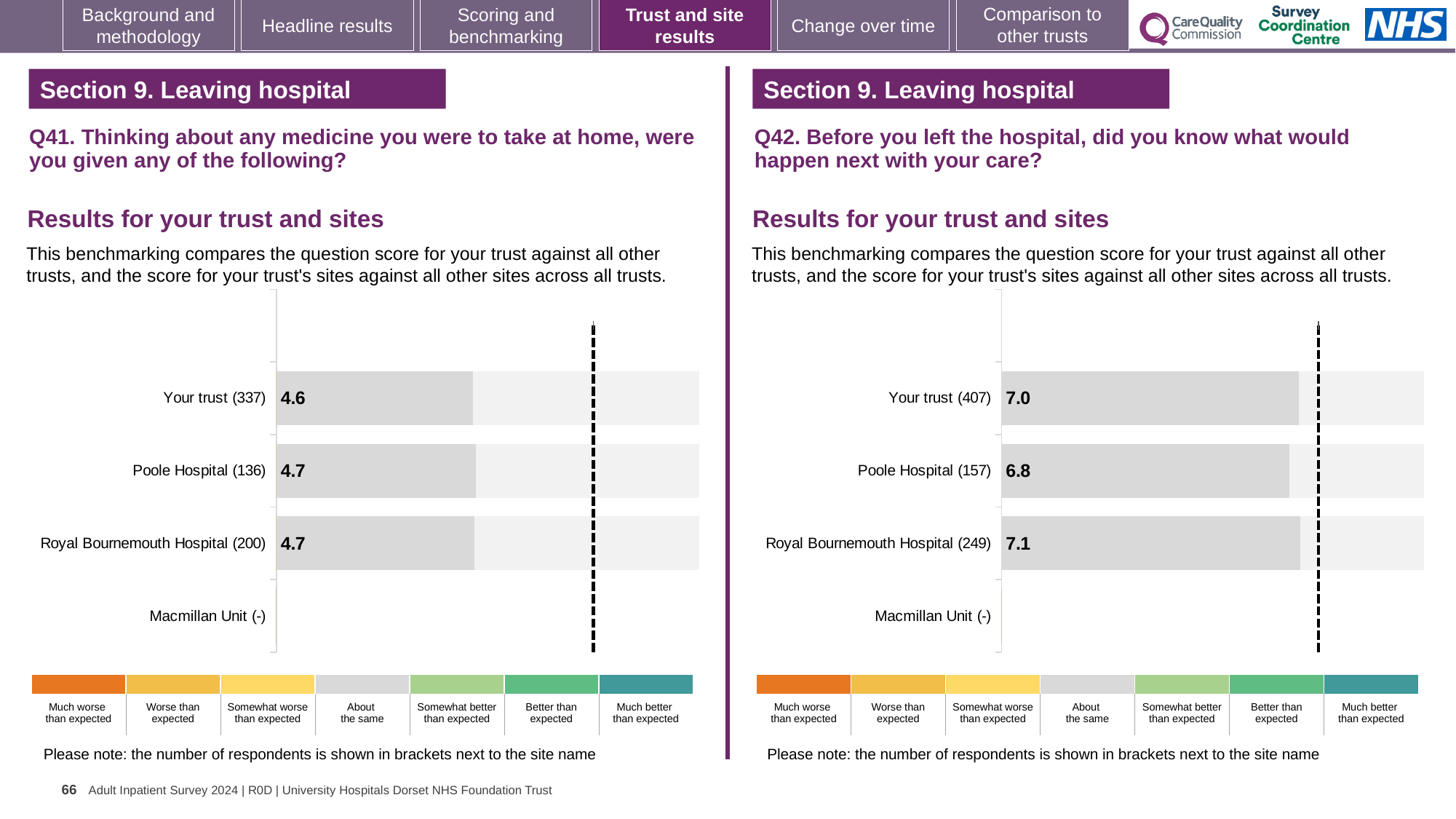
In the Q42 chart on the right, what is the score for Poole Hospital (157)? 6.8 In the Q41 chart on the left, which category has the lowest score among those with a value shown? Your trust (337) In the Q41 chart on the left, what is the score for Your trust (337)? 4.6 In the Q41 chart on the left, which has the larger score: Your trust (337) or Royal Bournemouth Hospital (200)? Royal Bournemouth Hospital (200) In the Q41 chart on the left, which category has no score shown? Macmillan Unit (-) In the Q42 chart on the right, which category has the lowest score among those with a value shown? Poole Hospital (157) In the Q41 chart on the left, what is the score for Poole Hospital (136)? 4.7 In the Q42 chart on the right, which category has the highest score? Royal Bournemouth Hospital (249) In the Q42 chart on the right, what is the score for Royal Bournemouth Hospital (249)? 7.1 What kind of chart is the Q41 chart on the left? Bar chart In the Q42 chart on the right, what is the difference between the scores for Royal Bournemouth Hospital (249) and Poole Hospital (157)? 0.3 How many categories are listed on the y axis of the Q42 chart on the right? 4